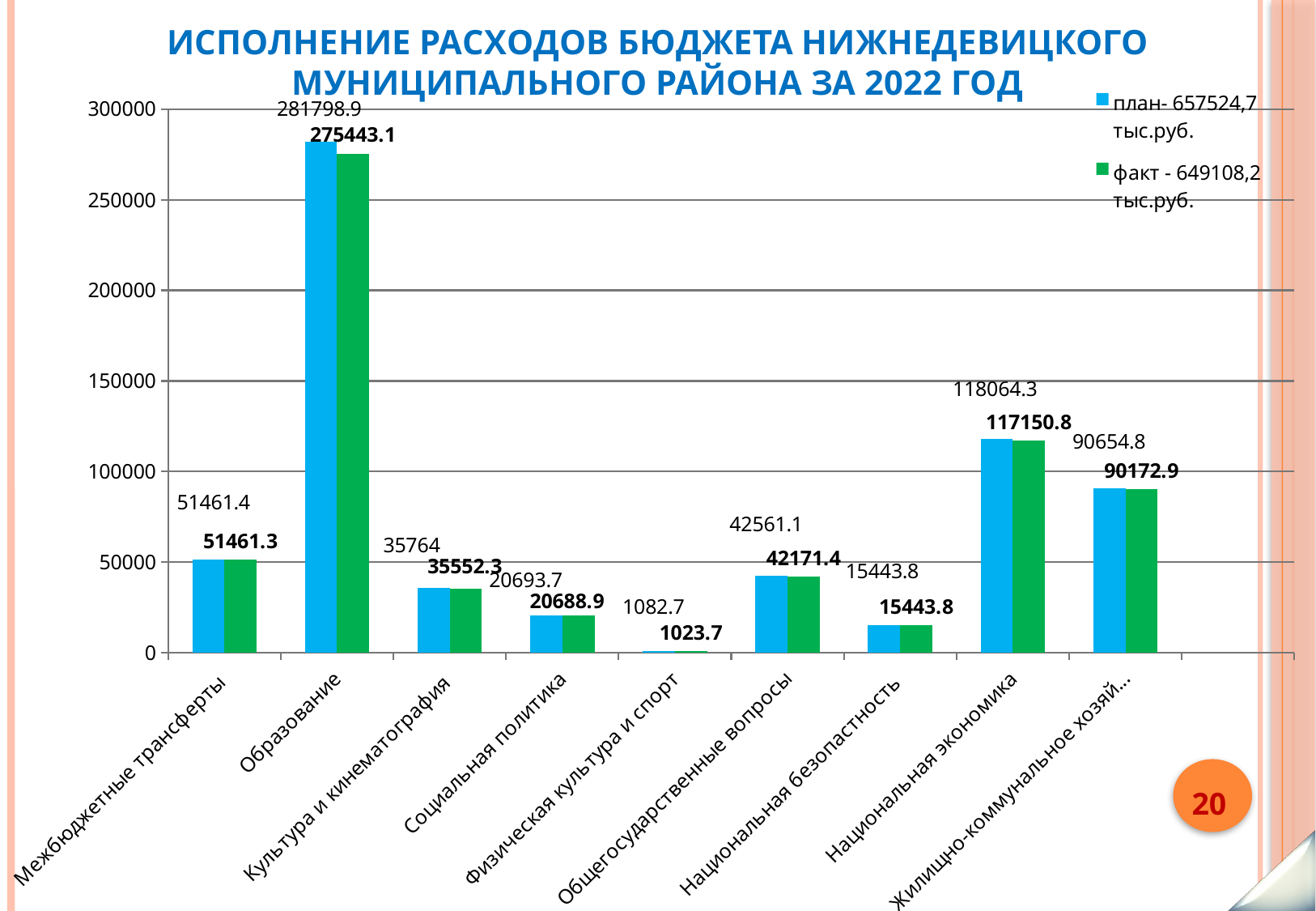
How many categories are shown on the x axis? 9 How many series does the legend list? 2 What is the факт (actual) value for Национальная экономика? 117150.8 What is the difference between the план and факт values for Национальная экономика? 913.5 Which category has the highest факт value? Образование What is the план (plan) value for Образование? 281798.9 What kind of chart is shown on the slide? Bar chart What is the факт value for Физическая культура и спорт? 1023.7 Which category has the lowest план value? Физическая культура и спорт What is the план value for Культура и кинематография? 35764 Which is larger: the факт value for Общегосударственные вопросы or the факт value for Культура и кинематография? Общегосударственные вопросы What is the difference between the план and факт values for Образование? 6355.8